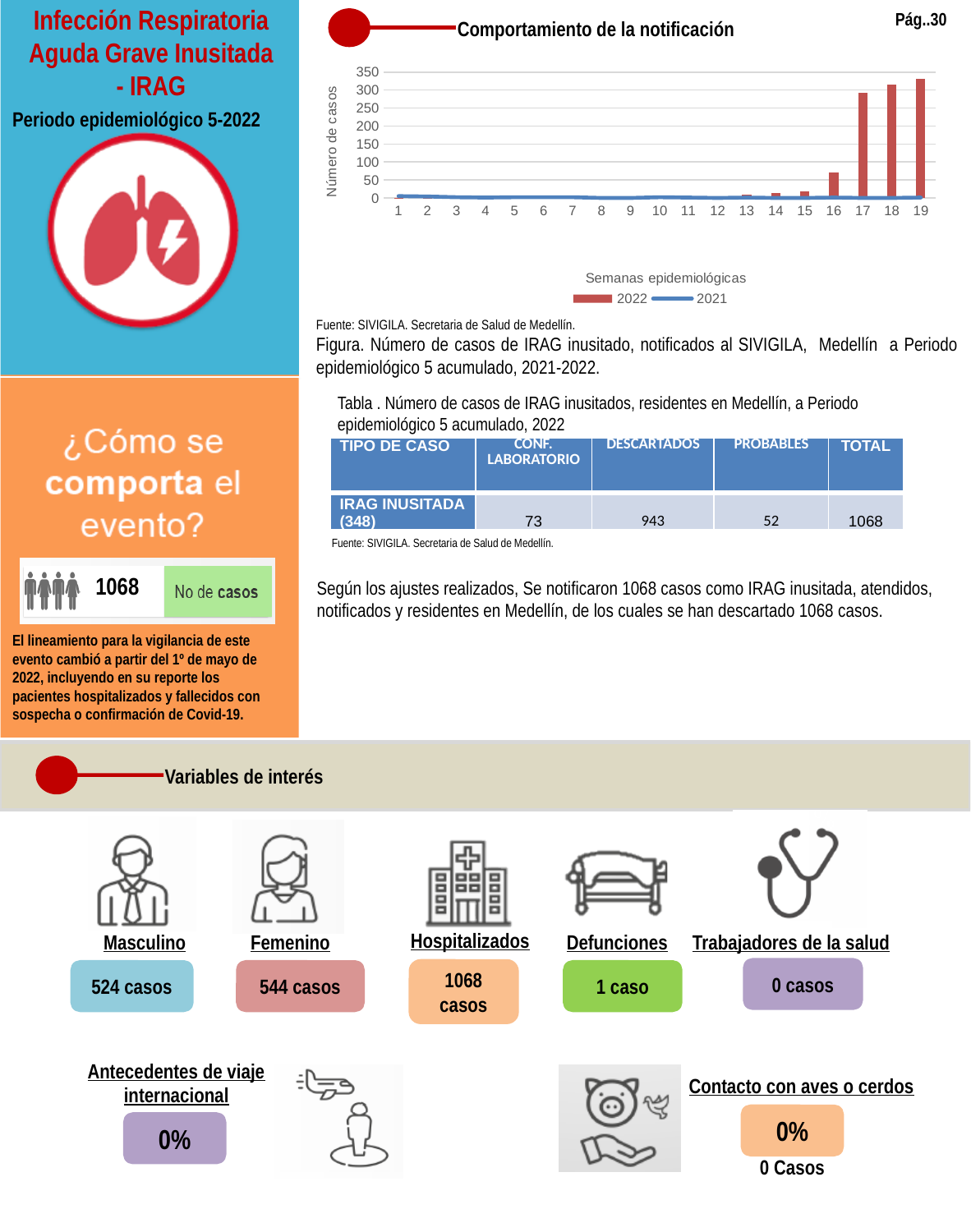
What kind of chart is shown under 'Comportamiento de la notificación'? combination bar and line chart In which week does the 2022 series reach its highest value? 19 Which two years are listed in the chart legend? 2022 and 2021 Is the 2022 value for week 17 greater or less than 250? greater What is the label of the y axis of the chart? Número de casos Is the 2022 value for week 19 greater or less than 300? greater Is the 2022 value for week 16 greater or less than 100? less How many epidemiological weeks are shown on the x axis of the chart? 19 How many series does the chart legend list? 2 Which week has the larger 2022 value, week 16 or week 17? 17 Do the 2022 values rise or fall from week 13 to week 19? rise